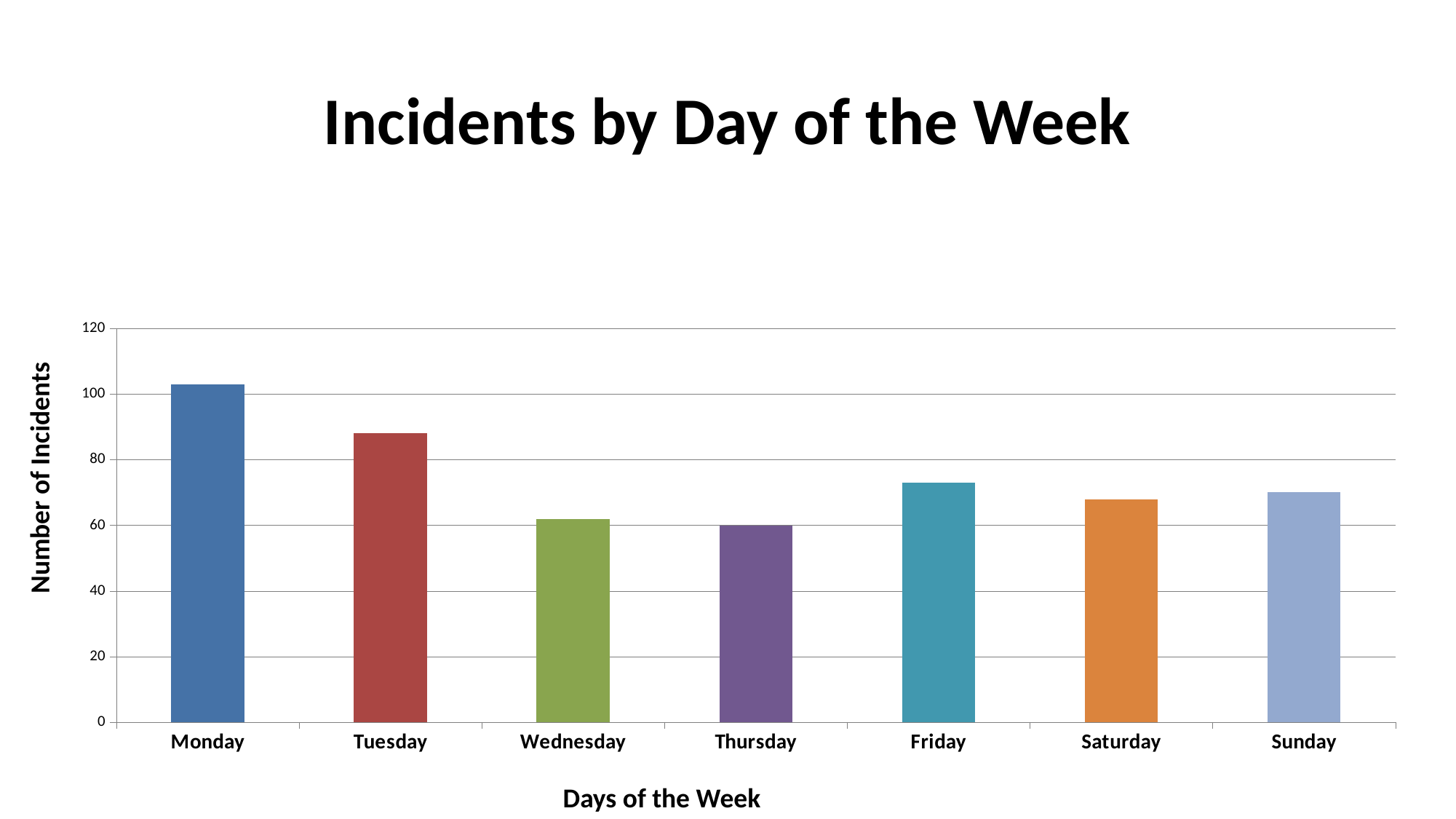
Which has more incidents, Tuesday or Friday? Tuesday Is the number of incidents for Wednesday greater or less than 80? less Which day of the week has the highest number of incidents? Monday What is the label on the vertical axis of the chart? Number of Incidents Which has more incidents, Monday or Tuesday? Monday Is the number of incidents for Tuesday greater or less than 100? less Is the number of incidents for Saturday greater or less than 80? less How many days of the week are plotted on the chart? 7 What type of chart is shown on the slide? bar chart